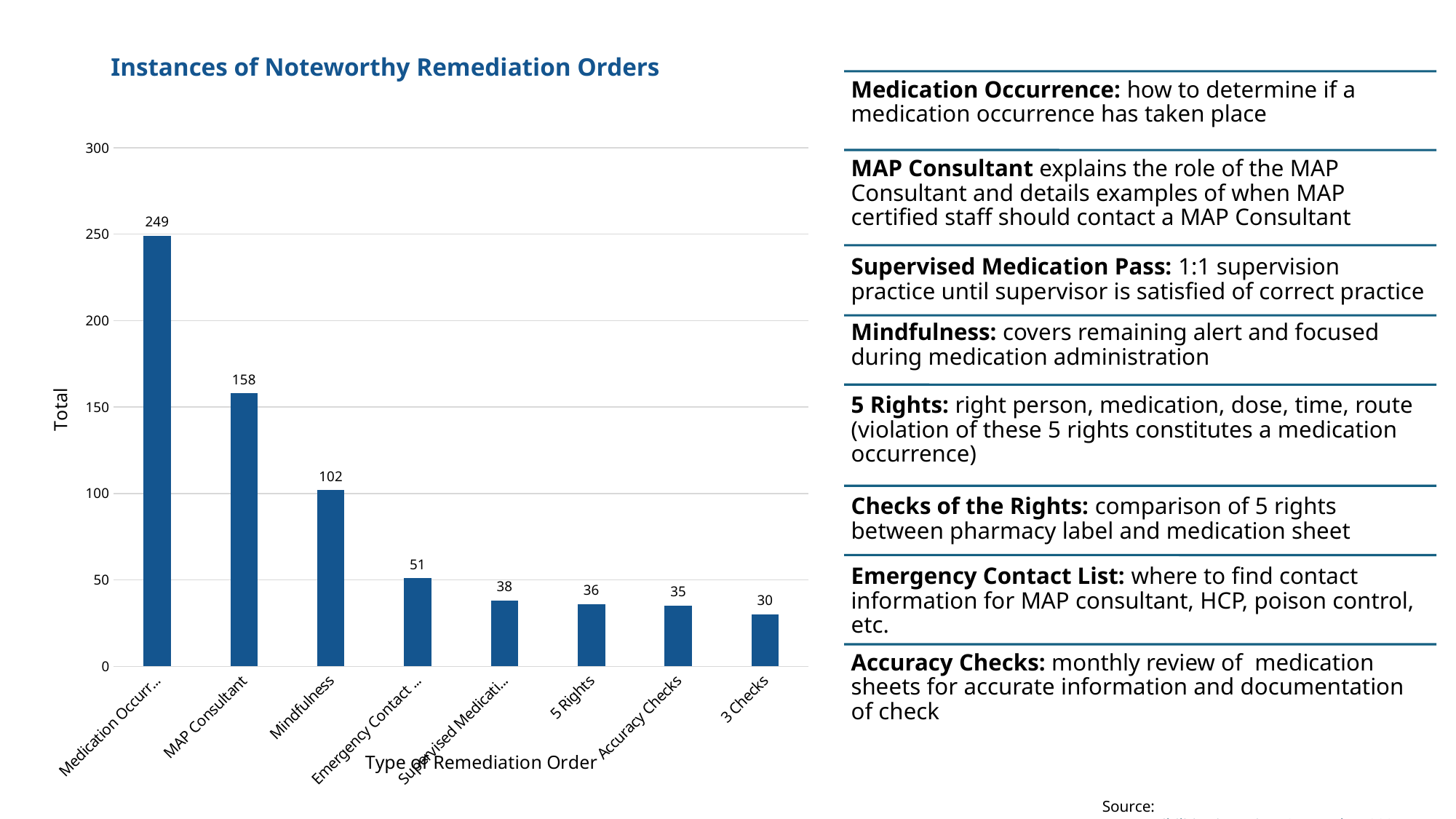
How many types of remediation order are shown in the chart? 8 Is the value for Mindfulness greater or less than 150? less What is the value for MAP Consultant? 158 What is the title of the chart? Instances of Noteworthy Remediation Orders Which is larger, the value for 5 Rights or the value for 3 Checks? 5 Rights Which type of remediation order has the lowest total? 3 Checks What is the difference between the values for MAP Consultant and Mindfulness? 56 What kind of chart is shown on the slide? bar chart What is the value for 5 Rights? 36 Which type of remediation order has the highest total? Medication Occurrence What is the value for Accuracy Checks? 35 What is the value for Mindfulness? 102